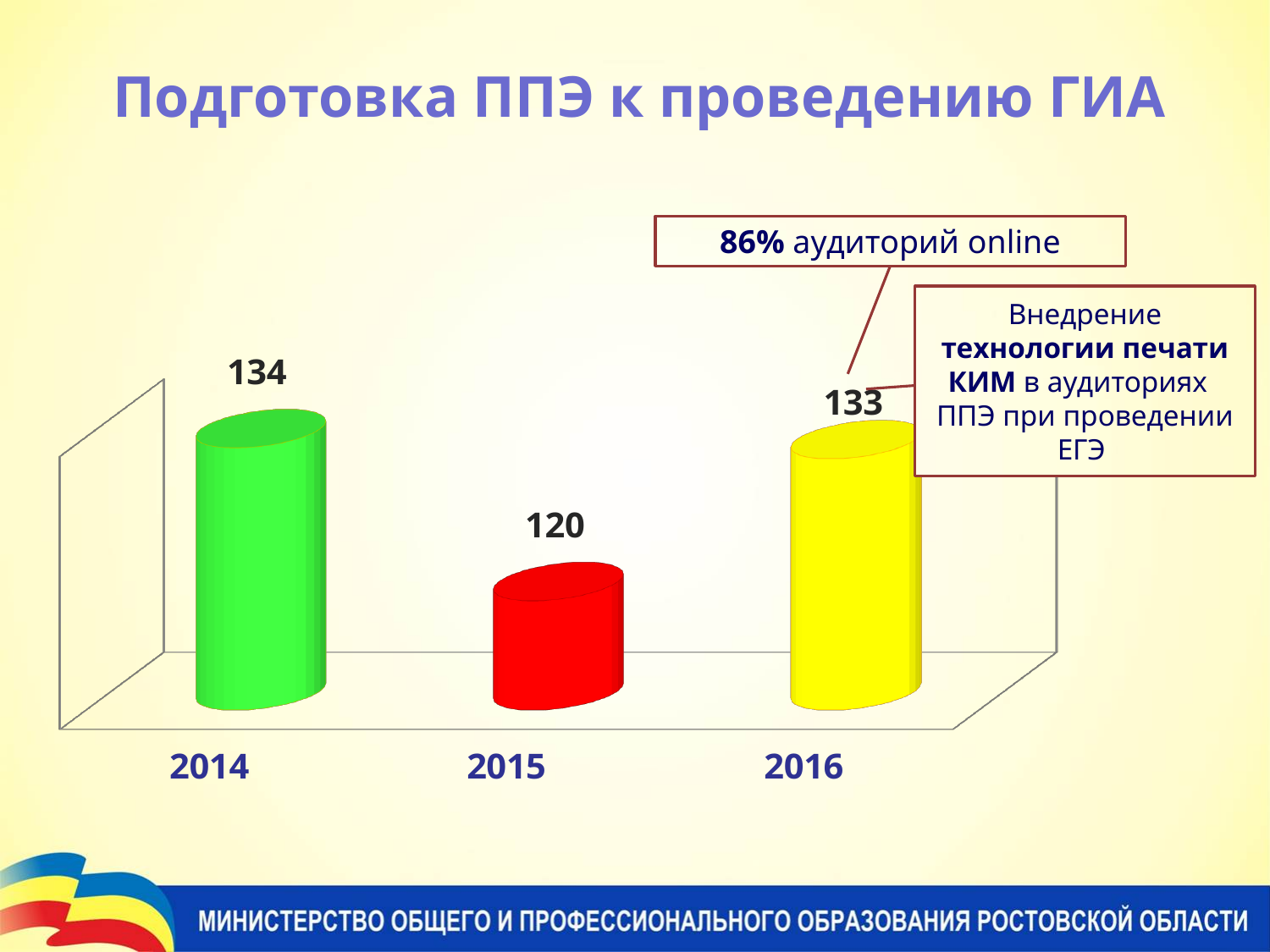
What is the difference between the values for 2014 and 2015? 14 How many years are shown on the chart? 3 What is the value for 2014? 134 Which is larger, the value for 2015 or the value for 2016? 2016 Does the value rise or fall from 2014 to 2015? fall Which year has the highest value? 2014 What colour is the bar for 2016? yellow What is the value for 2015? 120 What is the difference between the values for 2016 and 2015? 13 What kind of chart is shown on the slide? bar chart What is the value for 2016? 133 Which year has the lowest value? 2015